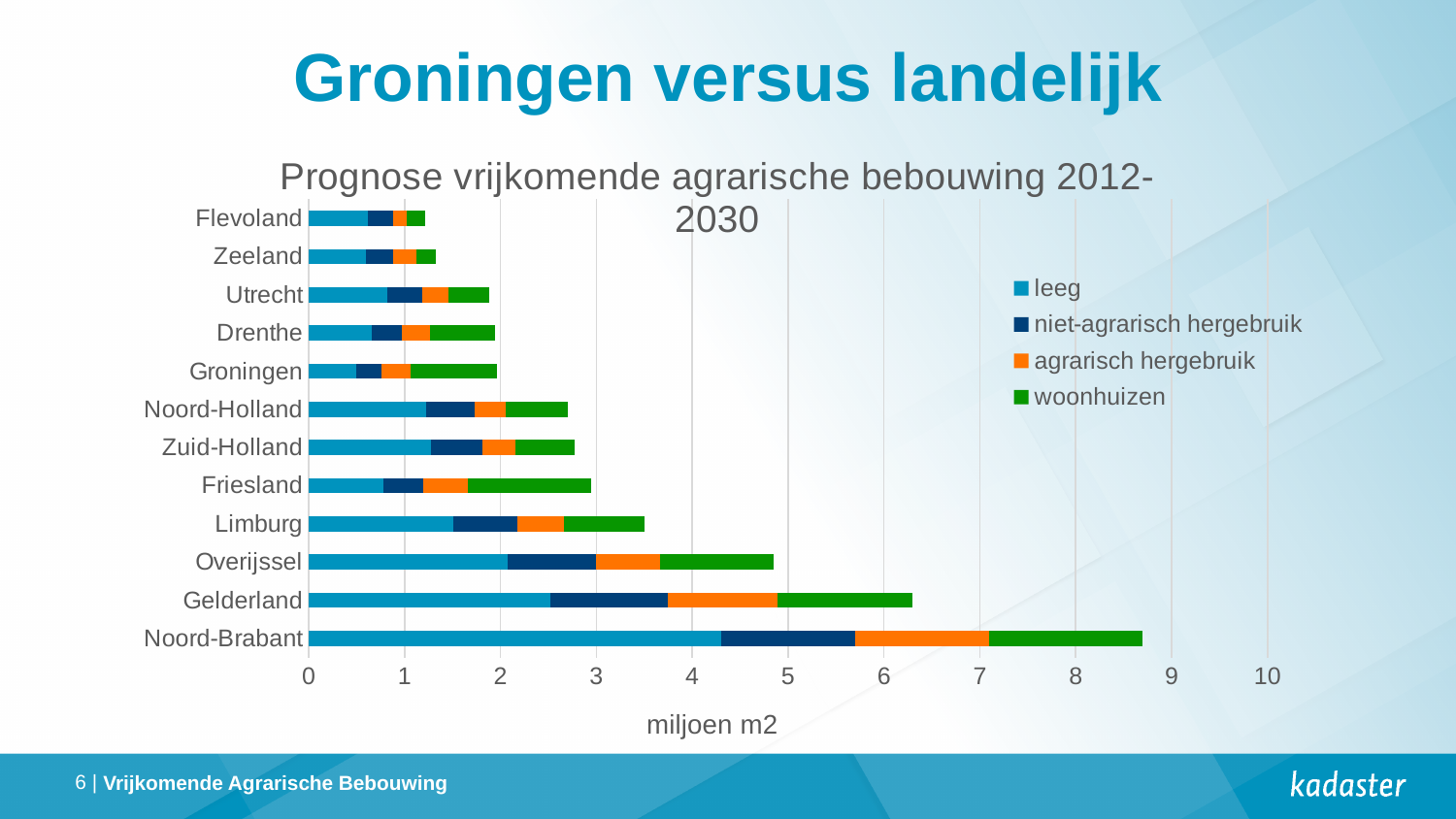
Which has the longer total bar, Gelderland or Overijssel? Gelderland What kind of chart is shown on the slide? Stacked bar chart Is the total bar for Noord-Brabant greater or less than 8 miljoen m2? greater Which has the longer total bar, Friesland or Limburg? Limburg What is the label on the horizontal axis of the chart? miljoen m2 Is the total bar for Groningen greater or less than 3 miljoen m2? less What is the title of the chart? Prognose vrijkomende agrarische bebouwing 2012-2030 Which province has the longest total bar? Noord-Brabant How many provinces are listed on the vertical axis of the chart? 12 How many series does the legend list? 4 Is the total bar for Overijssel greater or less than 5 miljoen m2? less